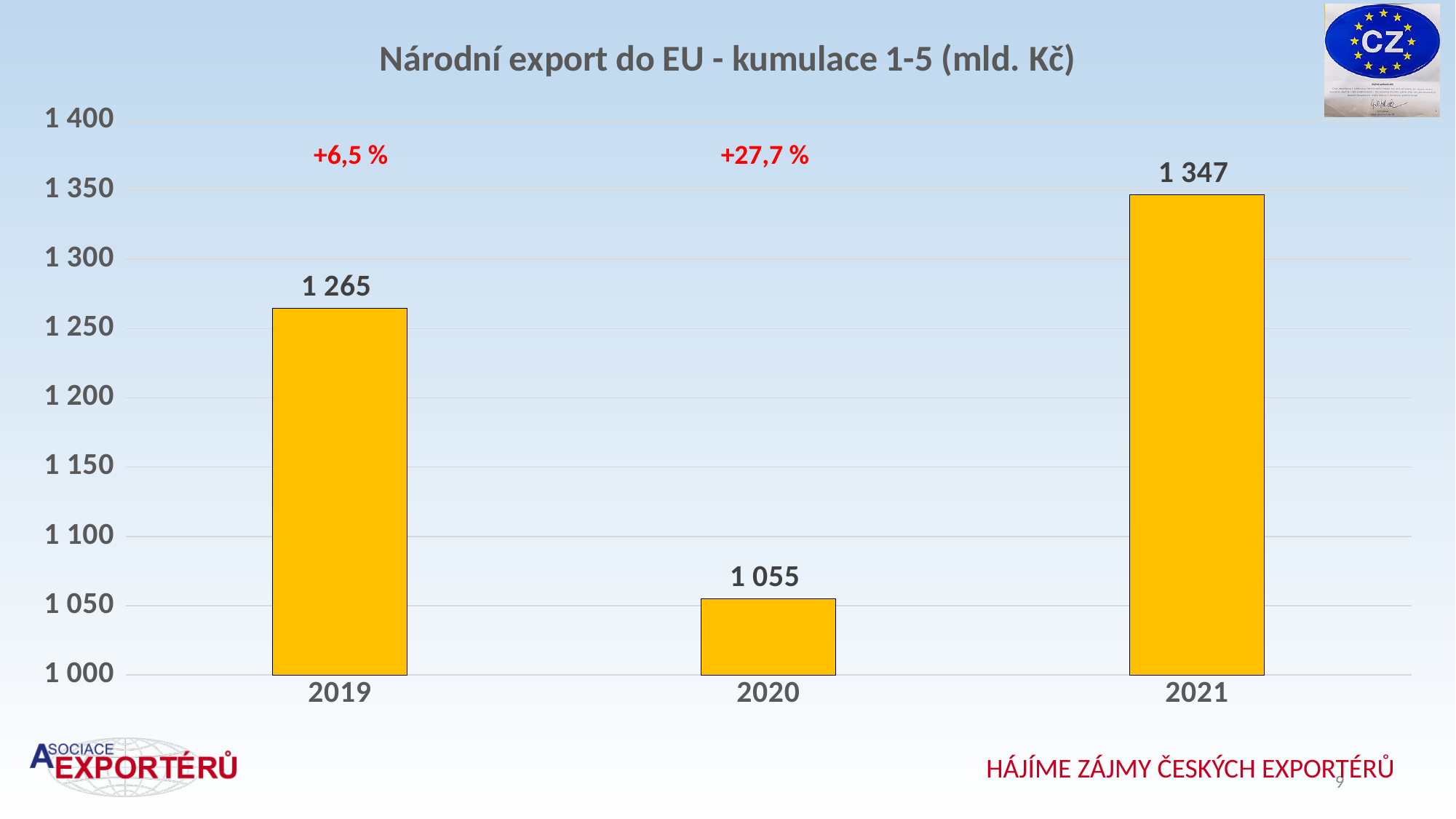
Which year has the lowest value? 2020 What is the difference between the values for 2019 and 2020? 210 What is the value for 2021? 1 347 What is the difference between the values for 2021 and 2020? 292 What is the title of the chart? Národní export do EU - kumulace 1-5 (mld. Kč) What kind of chart is shown on the slide? bar chart Which is larger, the value for 2019 or the value for 2021? 2021 Is the value for 2020 greater or less than 1 100? less Which year has the highest value? 2021 What is the value for 2019? 1 265 What is the value for 2020? 1 055 How many years are shown on the chart? 3